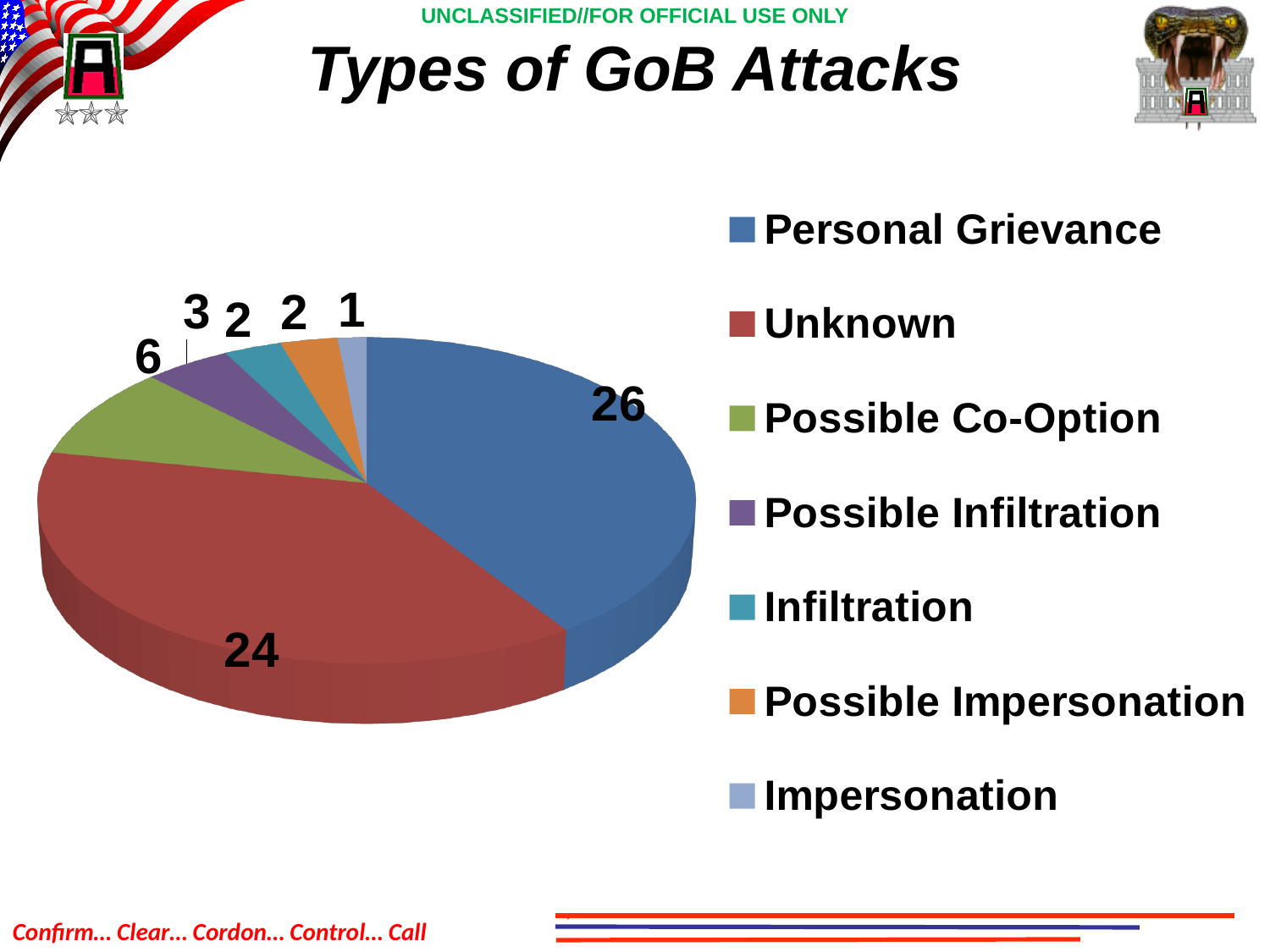
What is the value for Unknown? 24 What is the difference between the values for Unknown and Possible Co-Option? 18 What is the difference between the values for Personal Grievance and Unknown? 2 Which category has the largest slice of the pie? Personal Grievance What is the value for Personal Grievance? 26 What is the title of the chart? Types of GoB Attacks What type of chart is shown on the slide? pie chart What is the value for Possible Co-Option? 6 Which category has the smallest slice of the pie? Impersonation What is the value for Possible Infiltration? 3 How many categories does the legend list? 7 What is the value for Impersonation? 1